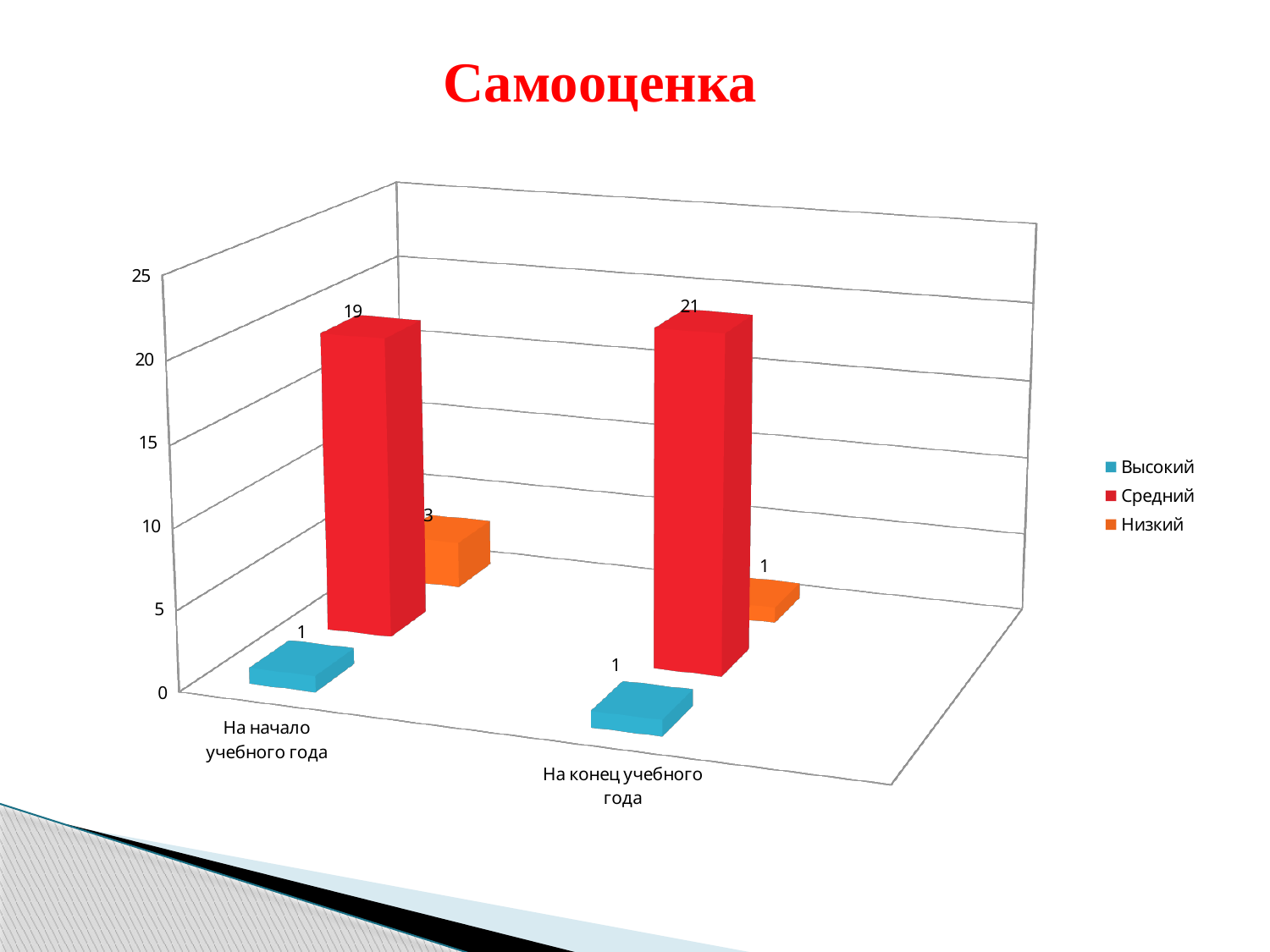
Which series has the highest value at На начало учебного года? Средний What is the difference between the Средний values at На конец учебного года and На начало учебного года? 2 Which series has the lowest value at На начало учебного года? Высокий Which is larger: Низкий at На начало учебного года or Низкий at На конец учебного года? На начало учебного года What is the title of the chart? Самооценка What is the value for Средний at На конец учебного года? 21 How many series does the legend list? 3 What is the value for Средний at На начало учебного года? 19 What is the value for Низкий at На начало учебного года? 3 What is the value for Высокий at На конец учебного года? 1 What is the value for Низкий at На конец учебного года? 1 What type of chart is shown on the slide? bar chart